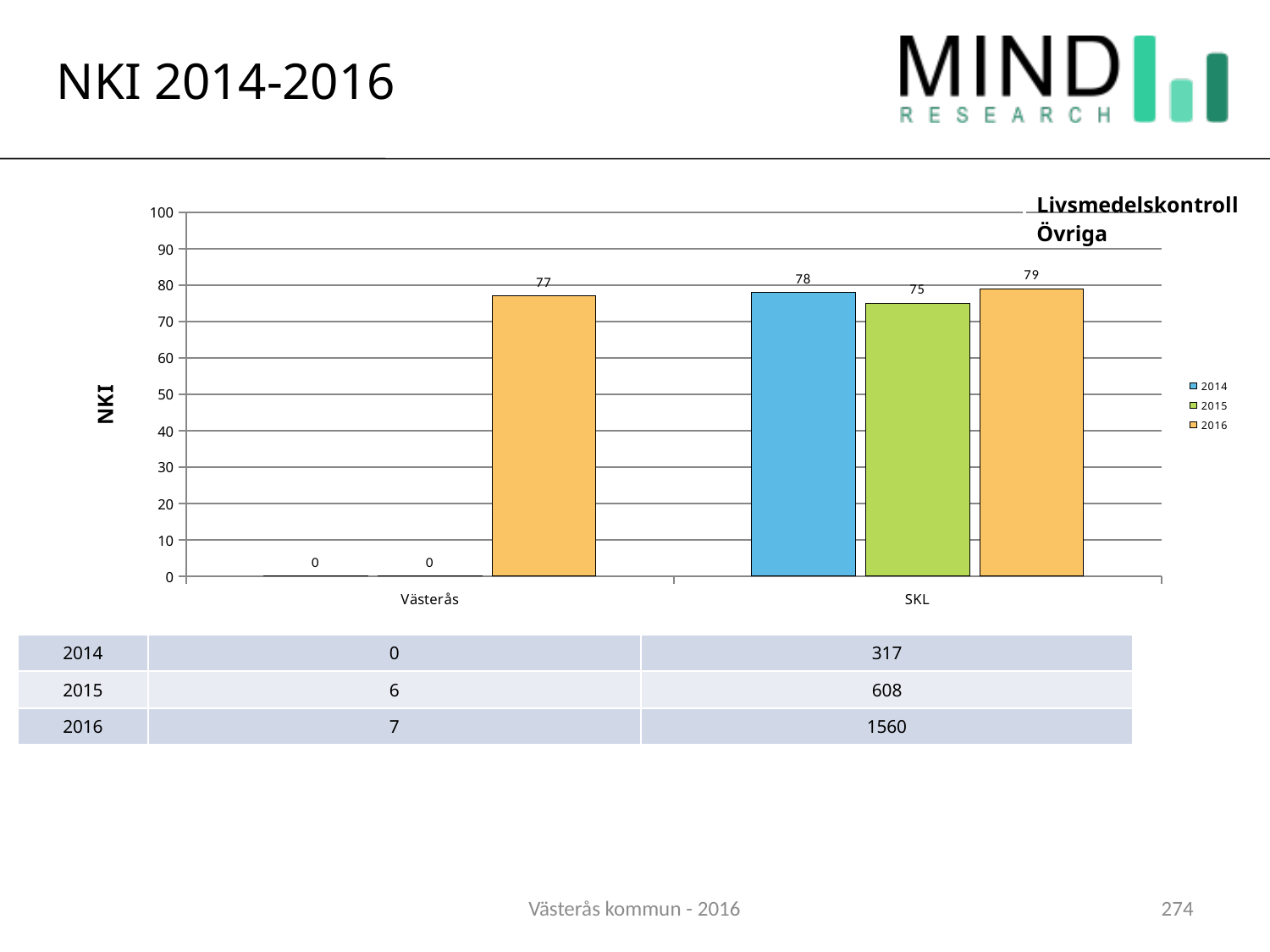
Which is larger, the 2016 NKI value for Västerås or the 2016 NKI value for SKL? SKL What is the NKI value for SKL in 2014? 78 What is the NKI value for Västerås in 2016? 77 What is the NKI value for Västerås in 2014? 0 How many categories are shown on the x axis? 2 What is the NKI value for SKL in 2015? 75 Which year has the highest NKI value for SKL? 2016 What kind of chart is shown on the slide? Bar chart What is the label on the vertical axis of the chart? NKI How many series does the legend list? 3 What is the difference between the SKL NKI values for 2016 and 2015? 4 Which year has the lowest NKI value for SKL? 2015